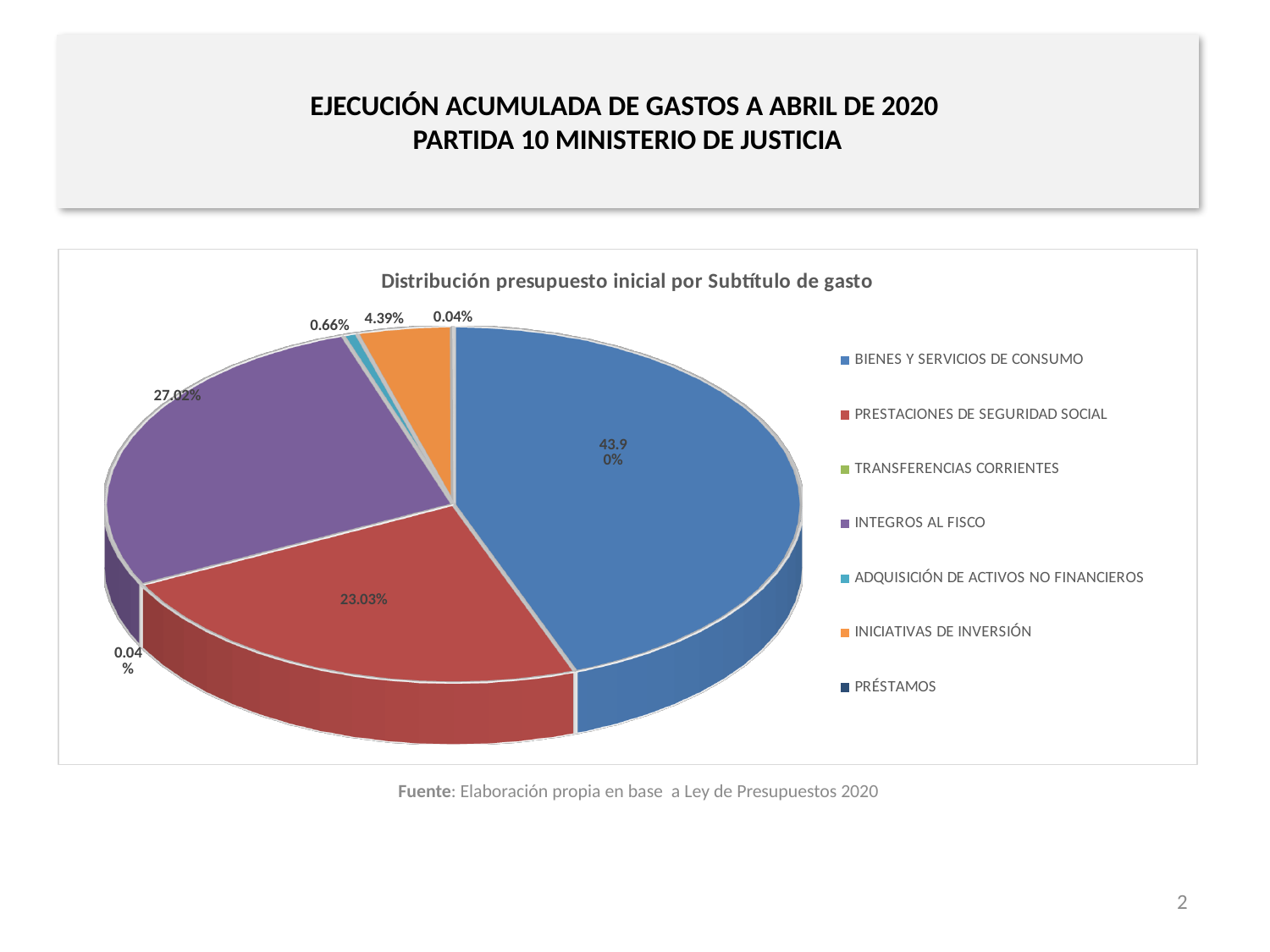
What type of chart is shown on the slide? pie chart What share of the pie does BIENES Y SERVICIOS DE CONSUMO represent? 43.90% What is the chart's title? Distribución presupuesto inicial por Subtítulo de gasto What share of the pie does INICIATIVAS DE INVERSIÓN represent? 4.39% Which is larger, the share for INTEGROS AL FISCO or for PRESTACIONES DE SEGURIDAD SOCIAL? INTEGROS AL FISCO What share of the pie does ADQUISICIÓN DE ACTIVOS NO FINANCIEROS represent? 0.66% What is the difference in percentage points between BIENES Y SERVICIOS DE CONSUMO and PRESTACIONES DE SEGURIDAD SOCIAL? 20.87% What share of the pie does PRESTACIONES DE SEGURIDAD SOCIAL represent? 23.03% How many entries does the legend list? 7 Which category has the largest share of the pie? BIENES Y SERVICIOS DE CONSUMO What share of the pie does INTEGROS AL FISCO represent? 27.02% What colour is the slice for INICIATIVAS DE INVERSIÓN? orange